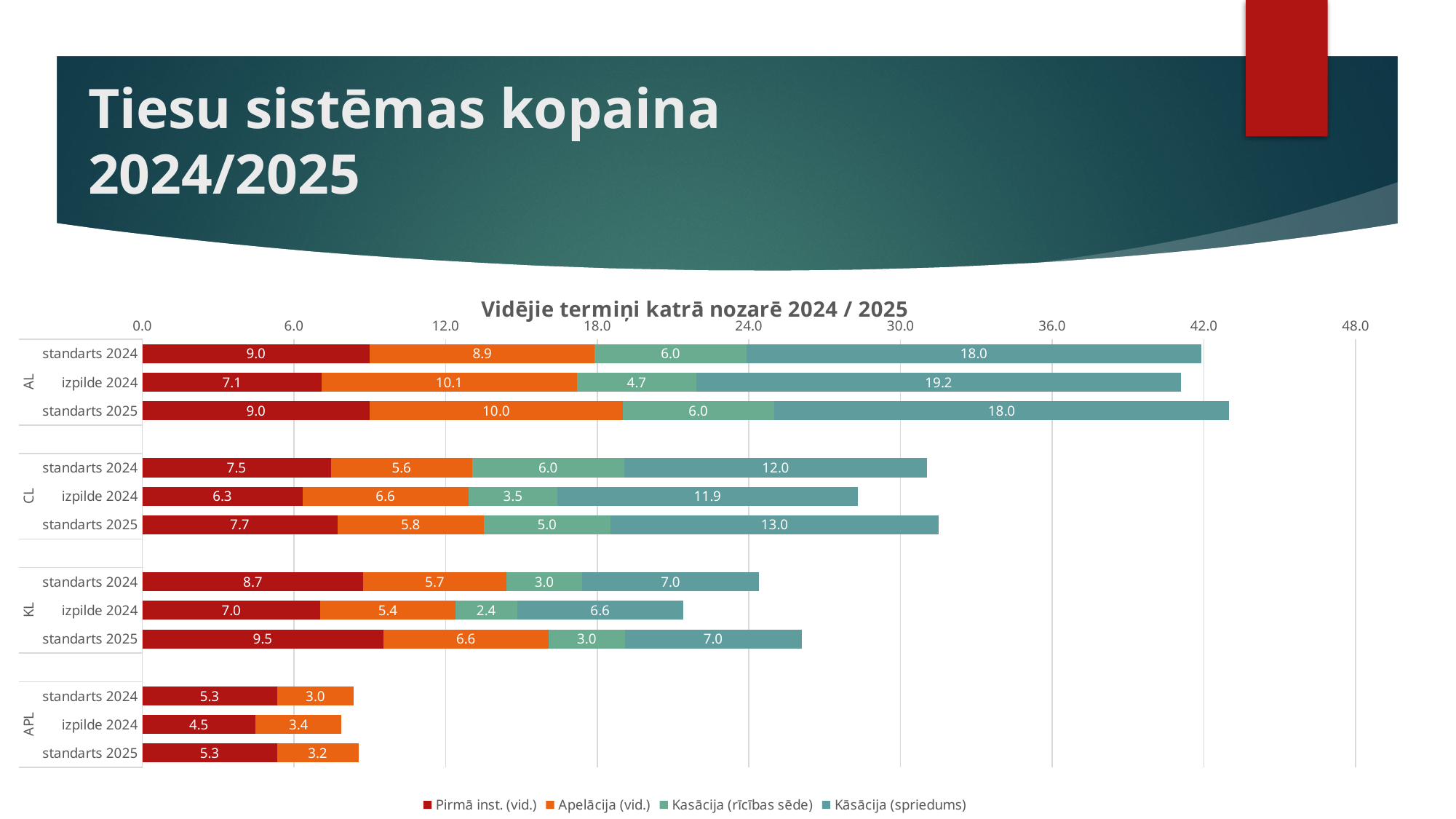
What is the title of the chart? Vidējie termiņi katrā nozarē 2024 / 2025 What is the Pirmā inst. (vid.) value for AL izpilde 2024? 7.1 What is the difference between the Kāsācija (spriedums) values for AL izpilde 2024 and AL standarts 2024? 1.2 What type of chart is shown on the slide? Stacked bar chart What is the Kāsācija (spriedums) value for CL standarts 2025? 13.0 Which bar has the largest Kāsācija (spriedums) value? AL izpilde 2024 What is the total of the stacked bar for APL standarts 2025? 8.5 How many series does the chart legend list? 4 What is the total of the stacked bar for KL izpilde 2024? 21.4 What is the Apelācija (vid.) value for APL izpilde 2024? 3.4 Which is larger: the Pirmā inst. (vid.) value for KL standarts 2025 or for KL standarts 2024? KL standarts 2025 Is the total length of the AL standarts 2025 bar greater or less than 42.0? greater